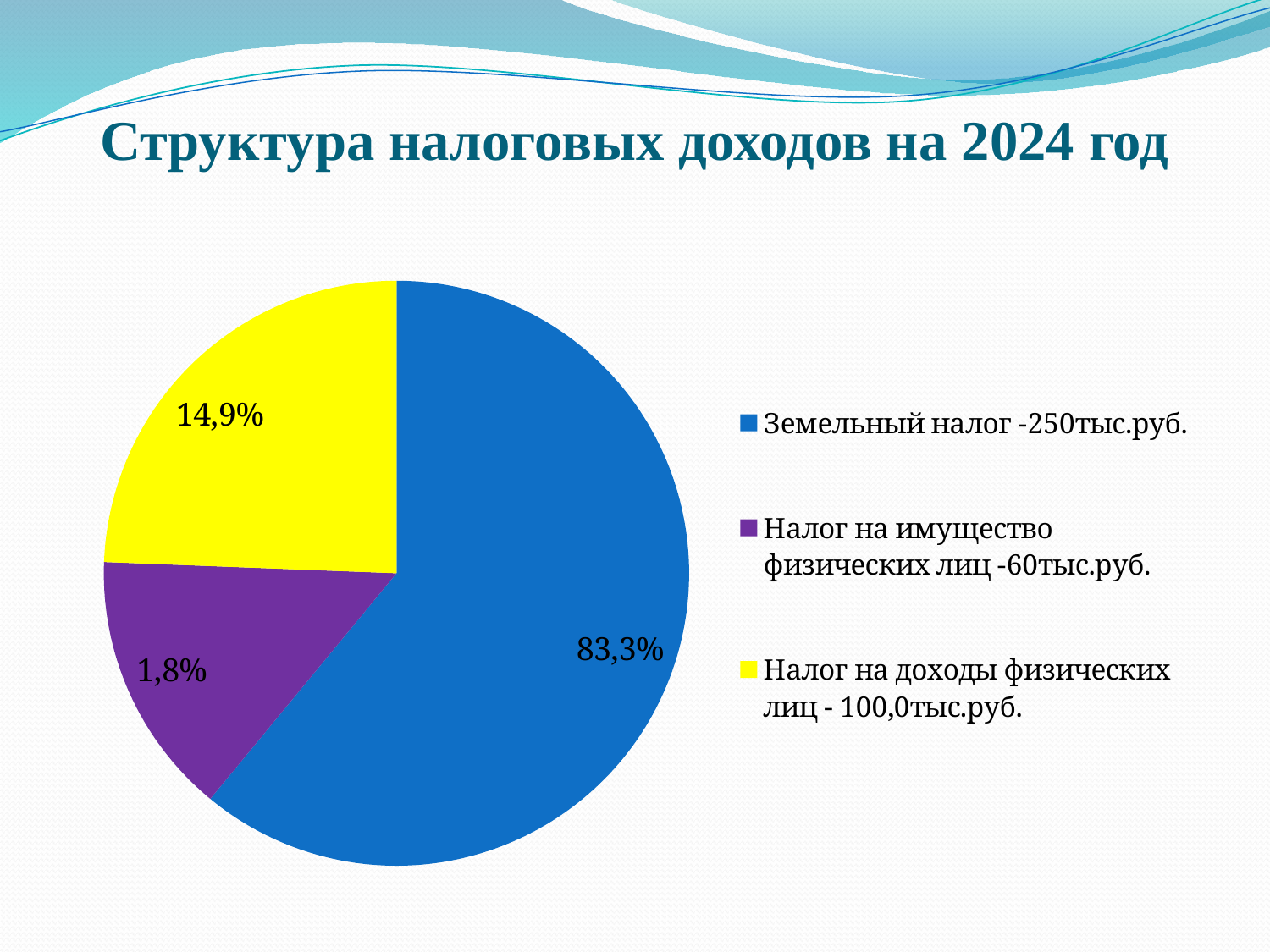
Which category has the largest share of the pie? Земельный налог -250тыс.руб. What is the difference in percentage points between the "Земельный налог" slice (83,3%) and the "Налог на доходы физических лиц" slice (14,9%)? 68,4 What colour is the slice representing "Налог на доходы физических лиц - 100,0тыс.руб."? yellow Which category has the smallest share of the pie? Налог на имущество физических лиц -60тыс.руб. How many entries does the legend list? 3 Which is larger: the share for "Земельный налог" or the share for "Налог на доходы физических лиц"? Земельный налог How many slices does the pie chart have? 3 What is the title of the chart on the slide? Структура налоговых доходов на 2024 год What kind of chart is shown on the slide? pie chart What percentage is shown for the slice labelled "Налог на доходы физических лиц - 100,0тыс.руб."? 14,9% What percentage is shown for the slice labelled "Земельный налог -250тыс.руб."? 83,3% What percentage is shown for the slice labelled "Налог на имущество физических лиц -60тыс.руб."? 1,8%